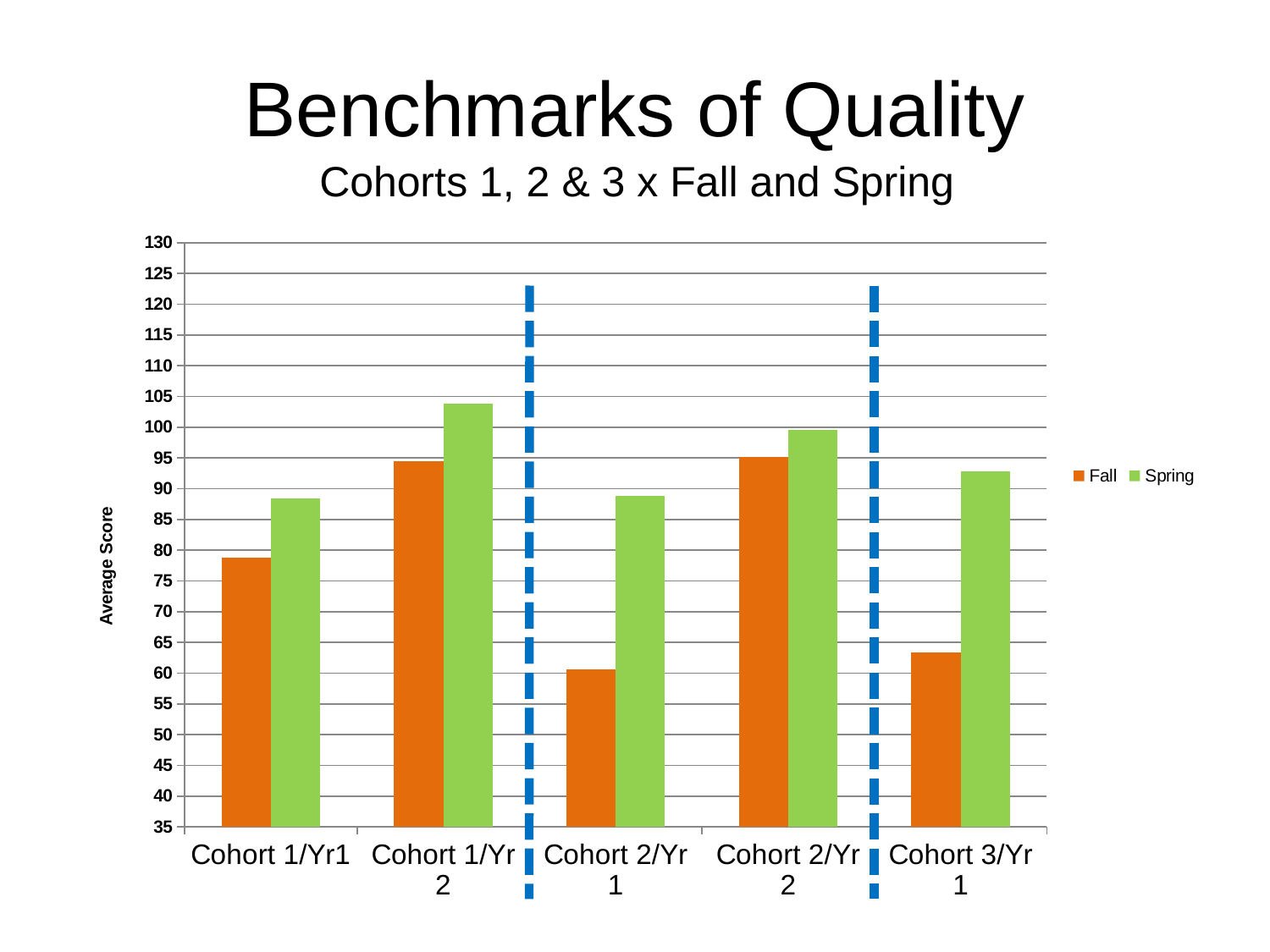
Which category has the lowest Fall value? Cohort 2/Yr 1 Is the Fall value for Cohort 2/Yr 1 greater or less than 65? less Is the Fall value for Cohort 1/Yr1 greater or less than 85? less Is the Spring value for Cohort 1/Yr 2 greater or less than 100? greater For Cohort 3/Yr 1, which is larger, the Fall value or the Spring value? Spring Which category has the highest Spring value? Cohort 1/Yr 2 What is the title of the vertical axis? Average Score Which is larger, the Fall value for Cohort 1/Yr1 or the Fall value for Cohort 3/Yr 1? Cohort 1/Yr1 What kind of chart is shown on the slide? Bar chart How many cohort/year categories are shown on the x axis? 5 How many series does the legend list? 2